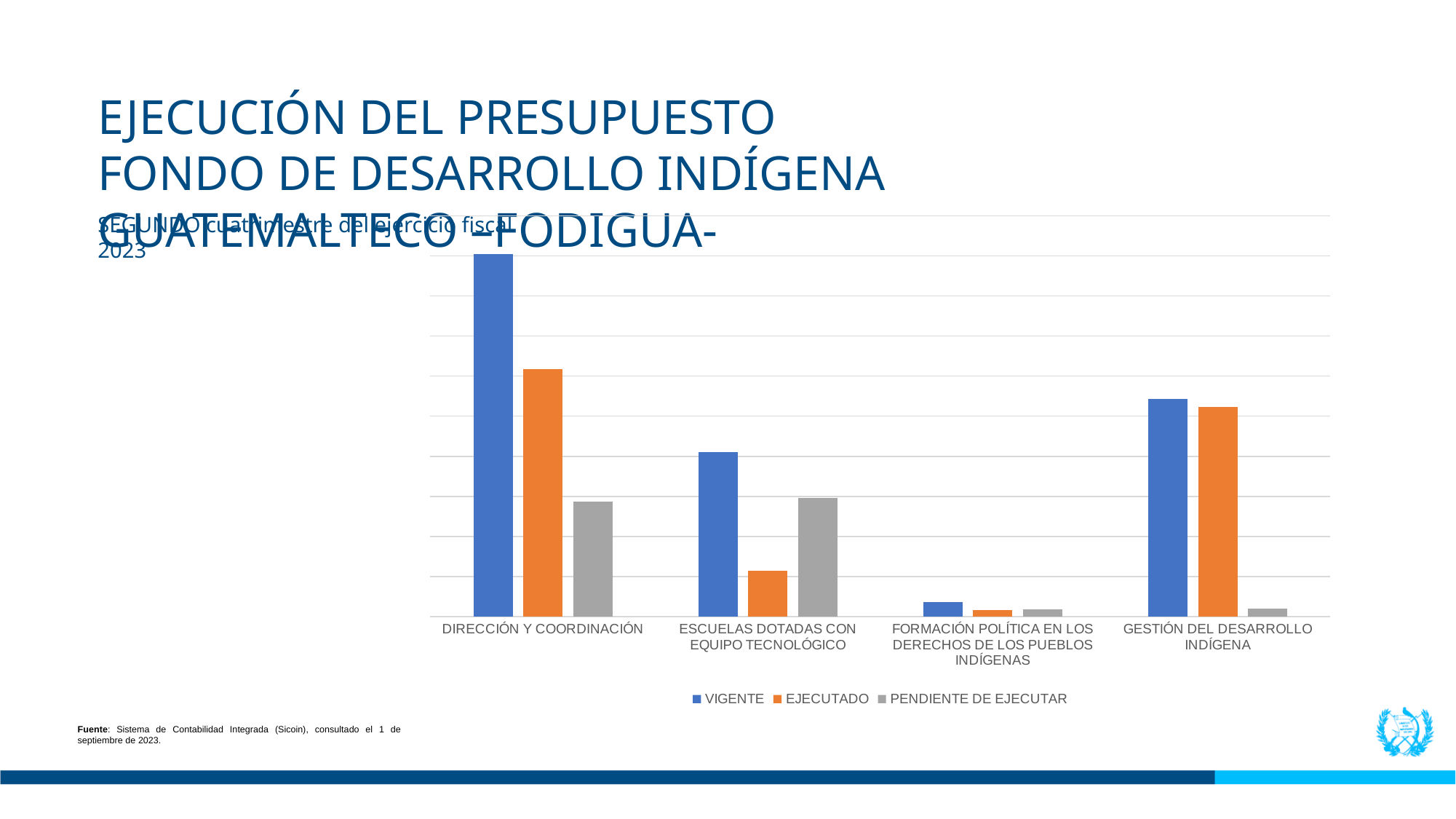
Which is larger: the VIGENTE value for DIRECCIÓN Y COORDINACIÓN or the VIGENTE value for GESTIÓN DEL DESARROLLO INDÍGENA? DIRECCIÓN Y COORDINACIÓN What kind of chart is shown on the slide? bar chart Which category has the highest EJECUTADO value? DIRECCIÓN Y COORDINACIÓN How many series does the chart legend list? 3 Which series is shown in orange in the chart? EJECUTADO For ESCUELAS DOTADAS CON EQUIPO TECNOLÓGICO, which is larger: VIGENTE or EJECUTADO? VIGENTE Which series is shown in grey in the chart? PENDIENTE DE EJECUTAR How many categories are shown on the x axis of the chart? 4 For ESCUELAS DOTADAS CON EQUIPO TECNOLÓGICO, which is larger: EJECUTADO or PENDIENTE DE EJECUTAR? PENDIENTE DE EJECUTAR Which category has the highest VIGENTE value? DIRECCIÓN Y COORDINACIÓN Which category has the lowest VIGENTE value? FORMACIÓN POLÍTICA EN LOS DERECHOS DE LOS PUEBLOS INDÍGENAS Which category has the lowest EJECUTADO value? FORMACIÓN POLÍTICA EN LOS DERECHOS DE LOS PUEBLOS INDÍGENAS